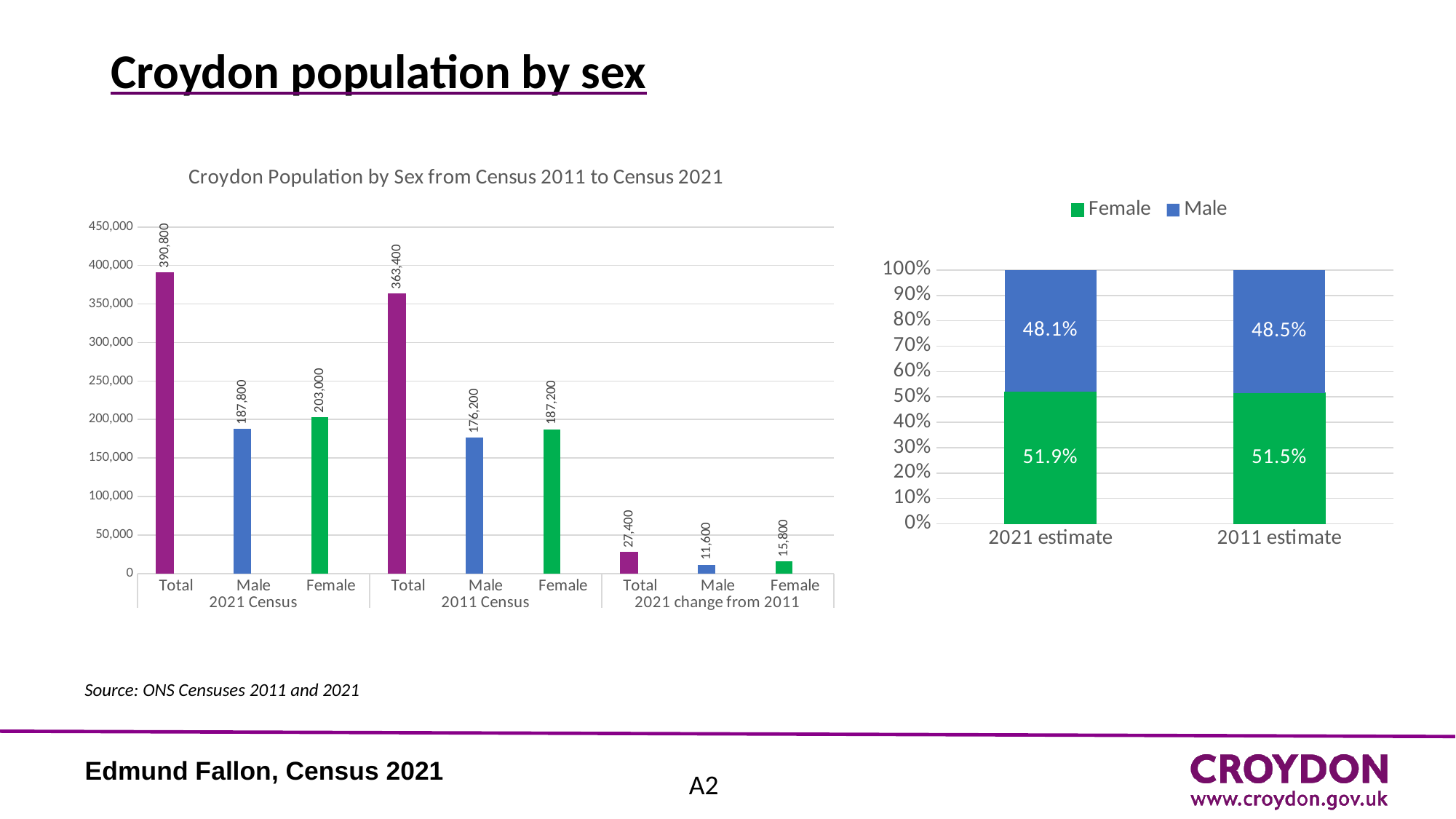
In the right chart, what is the Male share for the 2011 estimate? 48.5% In the right chart, how many series does the legend list? 2 In the left chart, which is larger: the Male value for the 2021 Census or the Male value for the 2011 Census? Male, 2021 Census What kind of chart is the right chart? Stacked bar chart In the left chart, what is the Male value under '2021 change from 2011'? 11,600 In the left chart, how many bars are plotted? 9 In the left chart 'Croydon Population by Sex from Census 2011 to Census 2021', what is the Total value for the 2021 Census? 390,800 In the left chart, which bar is the lowest? Male, 2021 change from 2011 In the left chart, what is the Female value for the 2011 Census? 187,200 In the left chart, what is the difference between the Female and Male values for the 2021 Census? 15,200 In the left chart, which bar is the highest? Total, 2021 Census In the right chart, what is the Female share for the 2021 estimate? 51.9%